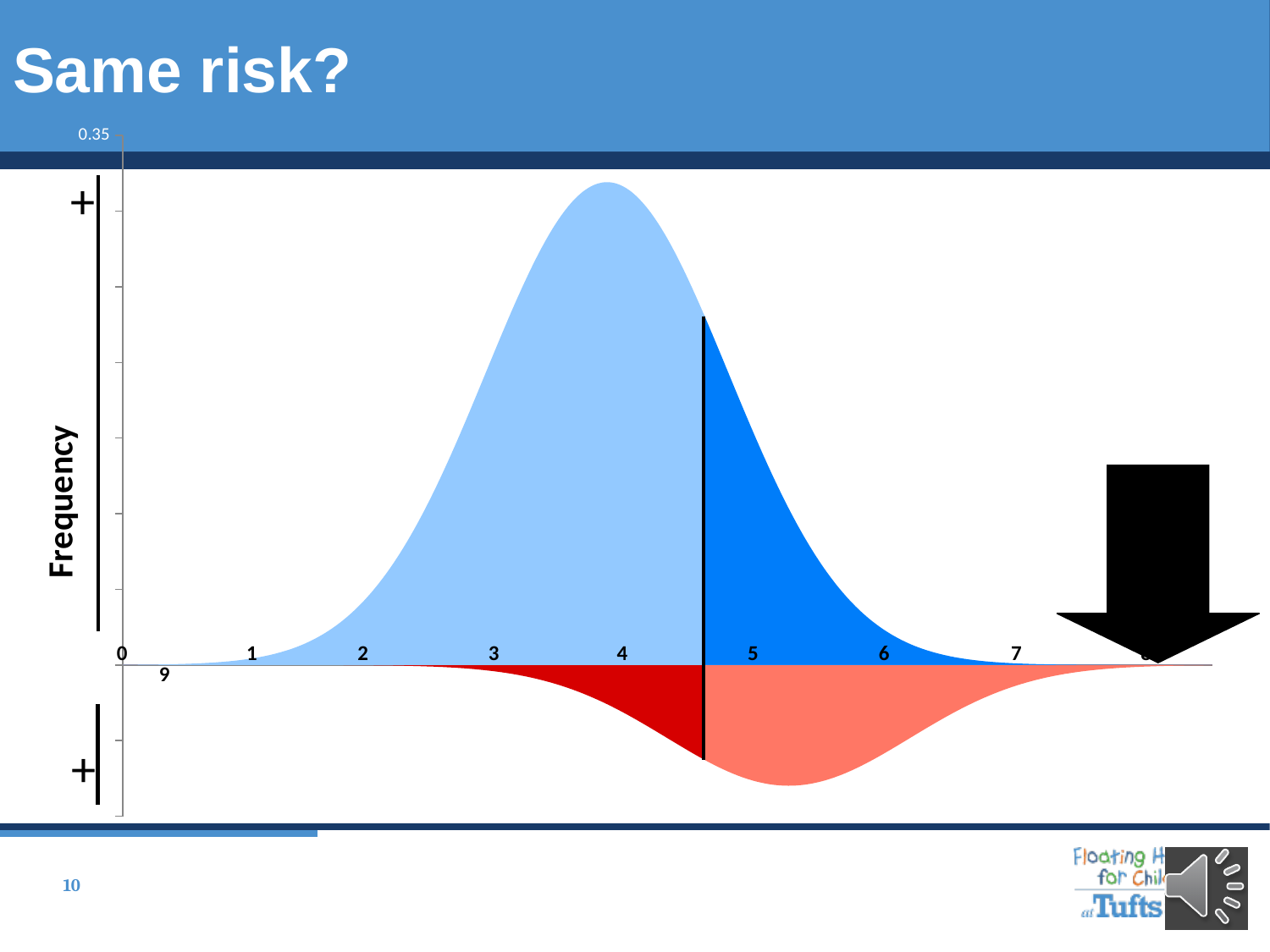
Moving from x = 5 to x = 7, does the blue curve above the axis rise or fall? fall Is the peak of the red curve below the axis located at an x value greater or less than 5? greater Is the peak of the blue curve located at an x value greater or less than 3? greater What is the label on the vertical axis of the chart? Frequency What kind of chart is shown on the slide? area chart Moving from x = 0 to x = 4, does the blue curve above the axis rise or fall? rise Is the peak of the blue curve above the horizontal axis greater or less than 0.35? less Which curve has its peak at a larger x value, the blue curve above the axis or the red curve below it? the red curve Which curve reaches farther from the horizontal axis, the blue curve above it or the red curve below it? the blue curve What is the title of the slide containing the chart? Same risk?